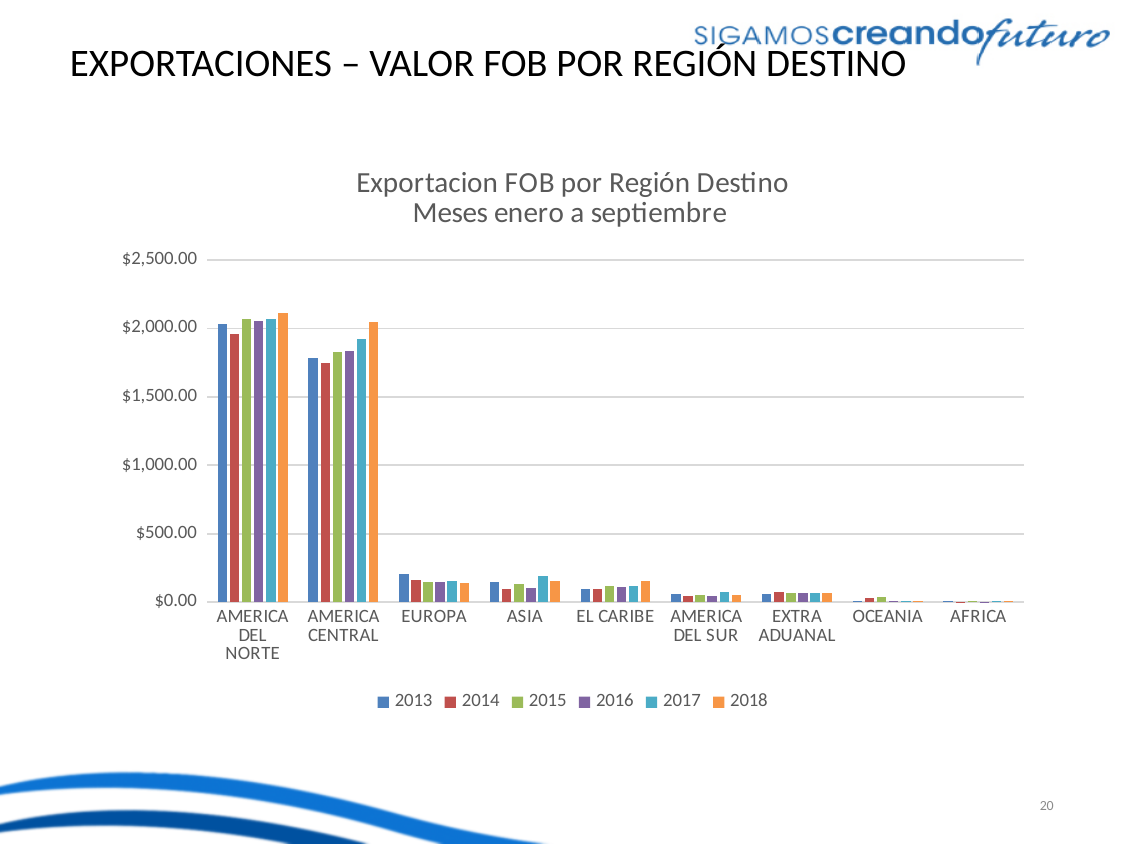
How many destination regions are shown on the x axis of the chart? 9 Is the 2018 value for AMERICA DEL NORTE greater or less than $2,000.00? greater What is the title of the chart? Exportacion FOB por Región Destino Meses enero a septiembre Which region has the lowest export values in the chart? AFRICA How many series does the chart legend list? 6 Is the 2013 value for AMERICA CENTRAL greater or less than $1,500.00? greater Is the 2013 value for EUROPA greater or less than $500.00? less Which is larger for 2018: AMERICA DEL NORTE or AMERICA CENTRAL? AMERICA DEL NORTE Which region has the highest export values in the chart? AMERICA DEL NORTE What kind of chart is shown on the slide? bar chart Within AMERICA CENTRAL, which year has the highest value? 2018